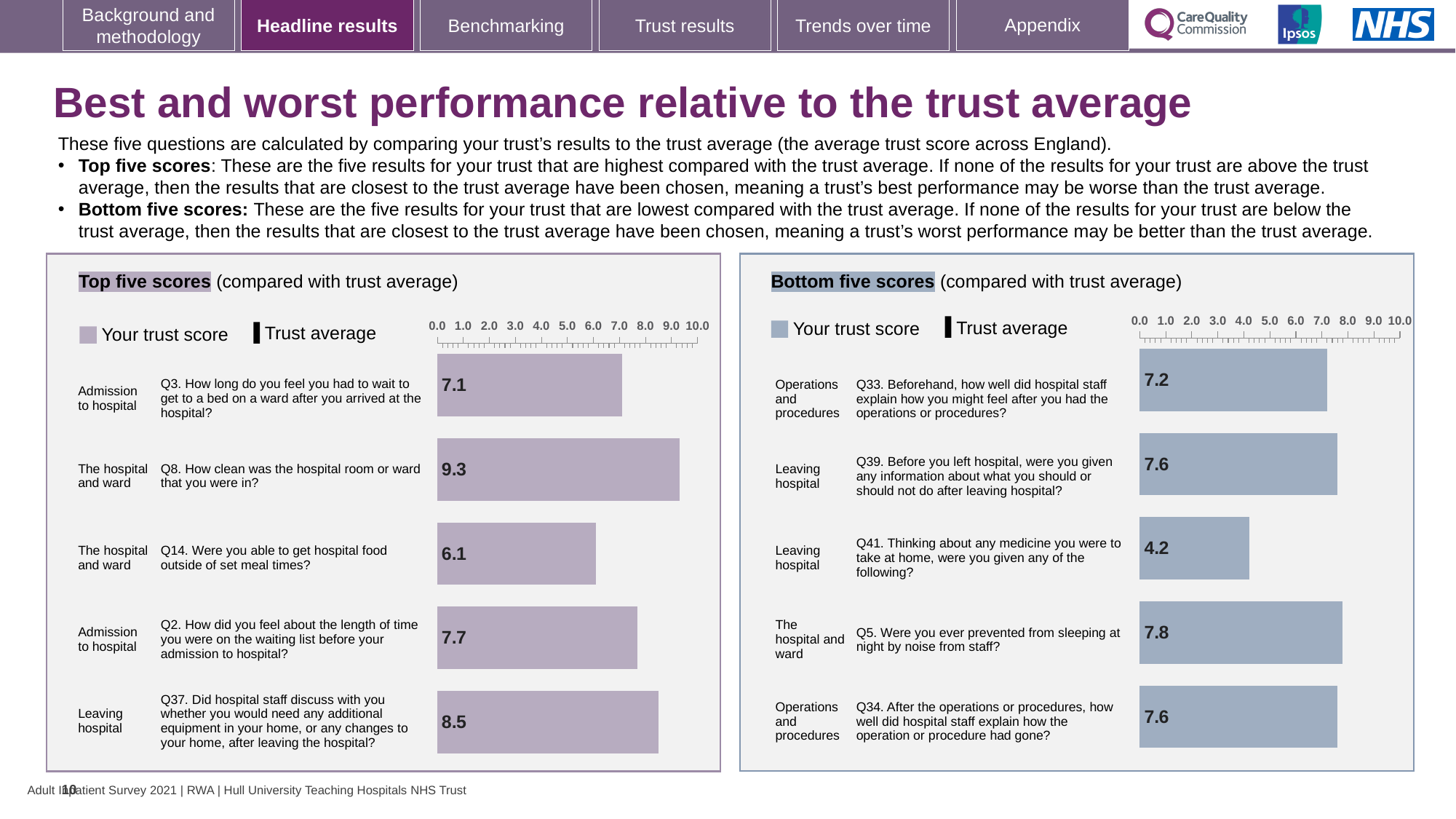
How many questions are shown in the Bottom five scores chart? 5 What type of chart is used in the Top five scores panel? Bar chart In the Bottom five scores chart, what is the difference between the trust scores for Q5 and Q41? 3.6 In the Top five scores chart, what is the trust score for Q14 (Were you able to get hospital food outside of set meal times?)? 6.1 In the Bottom five scores chart, which question has the lowest trust score? Q41. Thinking about any medicine you were to take at home, were you given any of the following? In the Top five scores chart, which question has the highest trust score? Q8. How clean was the hospital room or ward that you were in? How many series does the legend of the Top five scores chart list? 2 In the Bottom five scores chart, what is the trust score for Q5 (Were you ever prevented from sleeping at night by noise from staff?)? 7.8 In the Bottom five scores chart, what is the trust score for Q41 (Thinking about any medicine you were to take at home, were you given any of the following?)? 4.2 In the Top five scores chart, what is the difference between the trust scores for Q8 and Q14? 3.2 In the Top five scores chart, which has the larger trust score: Q3 or Q37? Q37 In the Top five scores chart, what is the trust score for Q8 (How clean was the hospital room or ward that you were in?)? 9.3